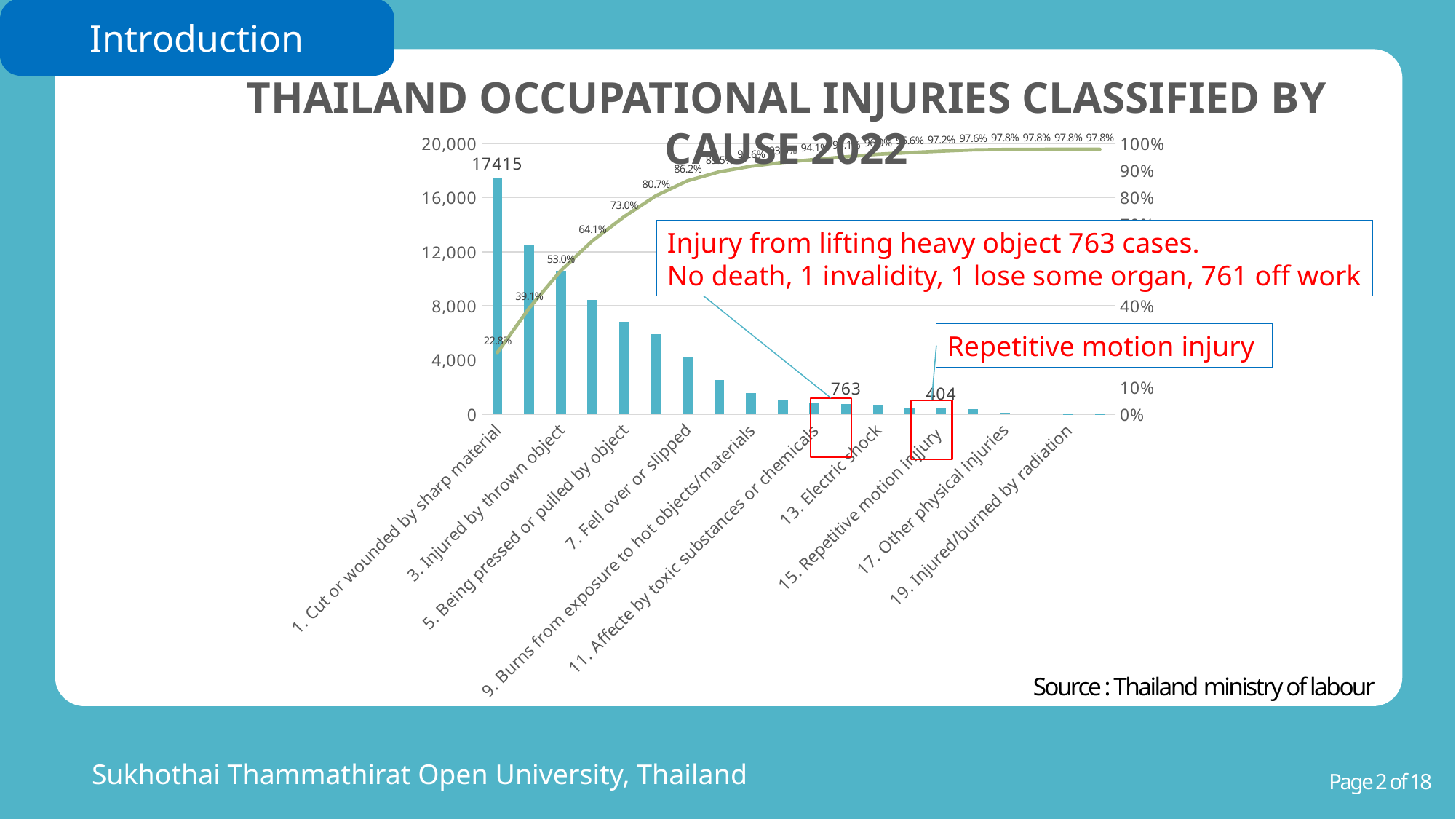
What is the difference between the cases for injury from lifting heavy object and '15. Repetitive motion injury'? 359 How many cases are shown for injury from lifting heavy object? 763 Which has more cases: injury from lifting heavy object or '15. Repetitive motion injury'? Injury from lifting heavy object What kind of chart is shown on the slide? bar chart (with a cumulative percentage line) What cumulative percentage is shown at '1. Cut or wounded by sharp material'? 22.8% Is the number of cases for '13. Electric shock' greater or less than 4,000? less What is the title of the chart? THAILAND OCCUPATIONAL INJURIES CLASSIFIED BY CAUSE 2022 Is the number of cases for '3. Injured by thrown object' greater or less than 8,000? greater Do the bar values rise or fall from left to right along the x axis? fall Which cause has the highest number of injuries? 1. Cut or wounded by sharp material How many cases are shown for '1. Cut or wounded by sharp material'? 17415 How many cases are shown for '15. Repetitive motion injury'? 404